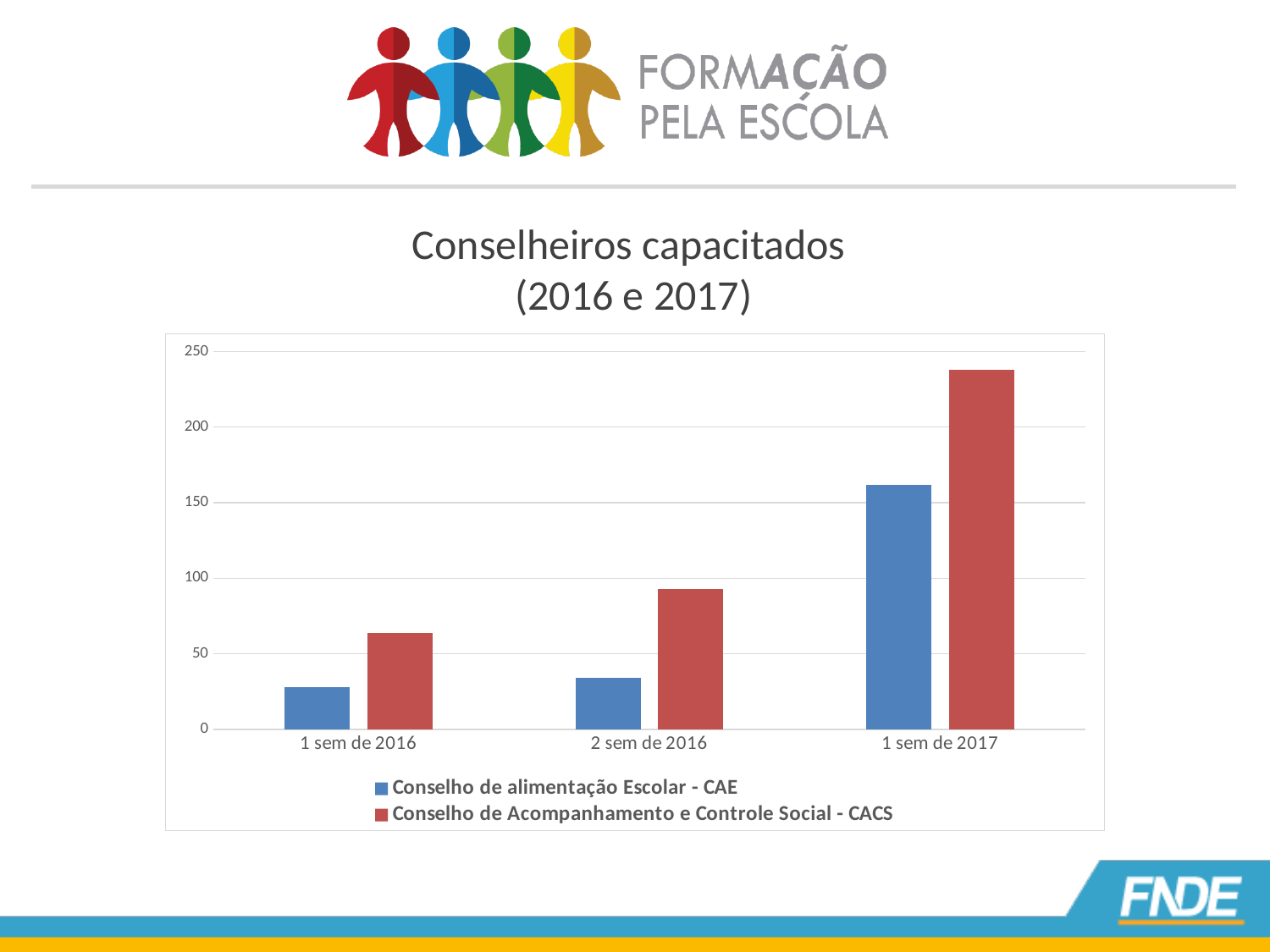
How many categories are shown on the x axis of the chart? 3 What kind of chart is shown on the slide? bar chart Which category has the highest value for Conselho de Acompanhamento e Controle Social - CACS? 1 sem de 2017 Which category has the lowest value for Conselho de alimentação Escolar - CAE? 1 sem de 2016 Is the value for Conselho de alimentação Escolar - CAE in 2 sem de 2016 greater or less than 50? less In 1 sem de 2017, which series has the larger value, CAE or CACS? CACS Is the value for Conselho de Acompanhamento e Controle Social - CACS in 1 sem de 2017 greater or less than 200? greater How many series does the chart's legend list? 2 Do the values for Conselho de alimentação Escolar - CAE rise or fall from 1 sem de 2016 to 1 sem de 2017? rise Which colour represents Conselho de Acompanhamento e Controle Social - CACS in the chart? red What is the title of the chart? Conselheiros capacitados (2016 e 2017) Is the value for Conselho de Acompanhamento e Controle Social - CACS in 2 sem de 2016 greater or less than 100? less